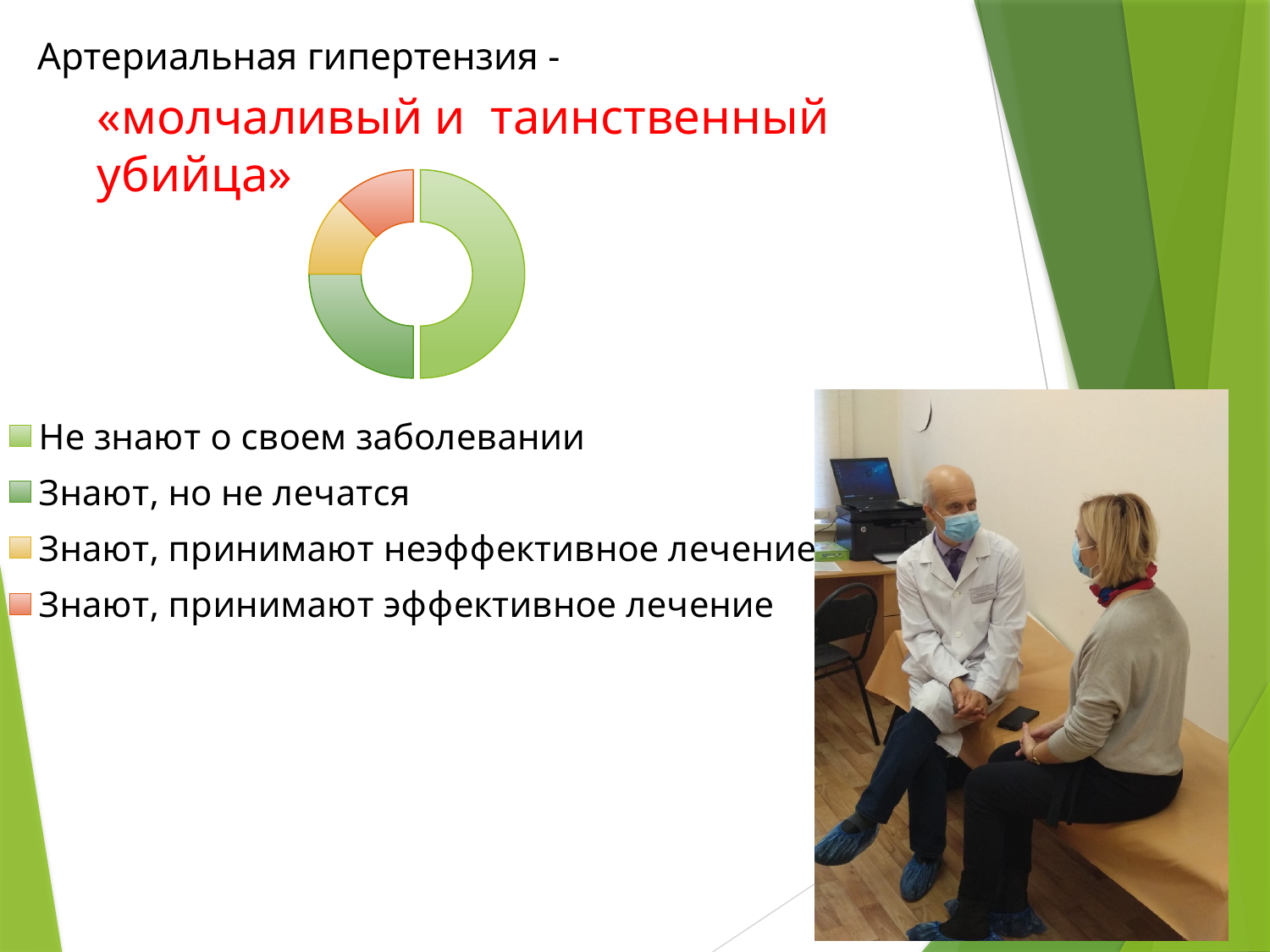
What colour represents "Знают, принимают эффективное лечение" in the doughnut chart? red Which is larger in the doughnut chart: the share for "Не знают о своем заболевании" or the share for "Знают, принимают неэффективное лечение"? Не знают о своем заболевании How many categories does the doughnut chart have? 4 What colour represents "Знают, принимают неэффективное лечение" in the doughnut chart? yellow How many entries does the legend of the doughnut chart list? 4 Which is larger in the doughnut chart: the share for "Не знают о своем заболевании" or the share for "Знают, но не лечатся"? Не знают о своем заболевании What kind of chart is shown on the slide? doughnut chart Which is larger in the doughnut chart: the share for "Знают, но не лечатся" or the share for "Знают, принимают эффективное лечение"? Знают, но не лечатся Which category takes the largest share of the doughnut chart? Не знают о своем заболевании